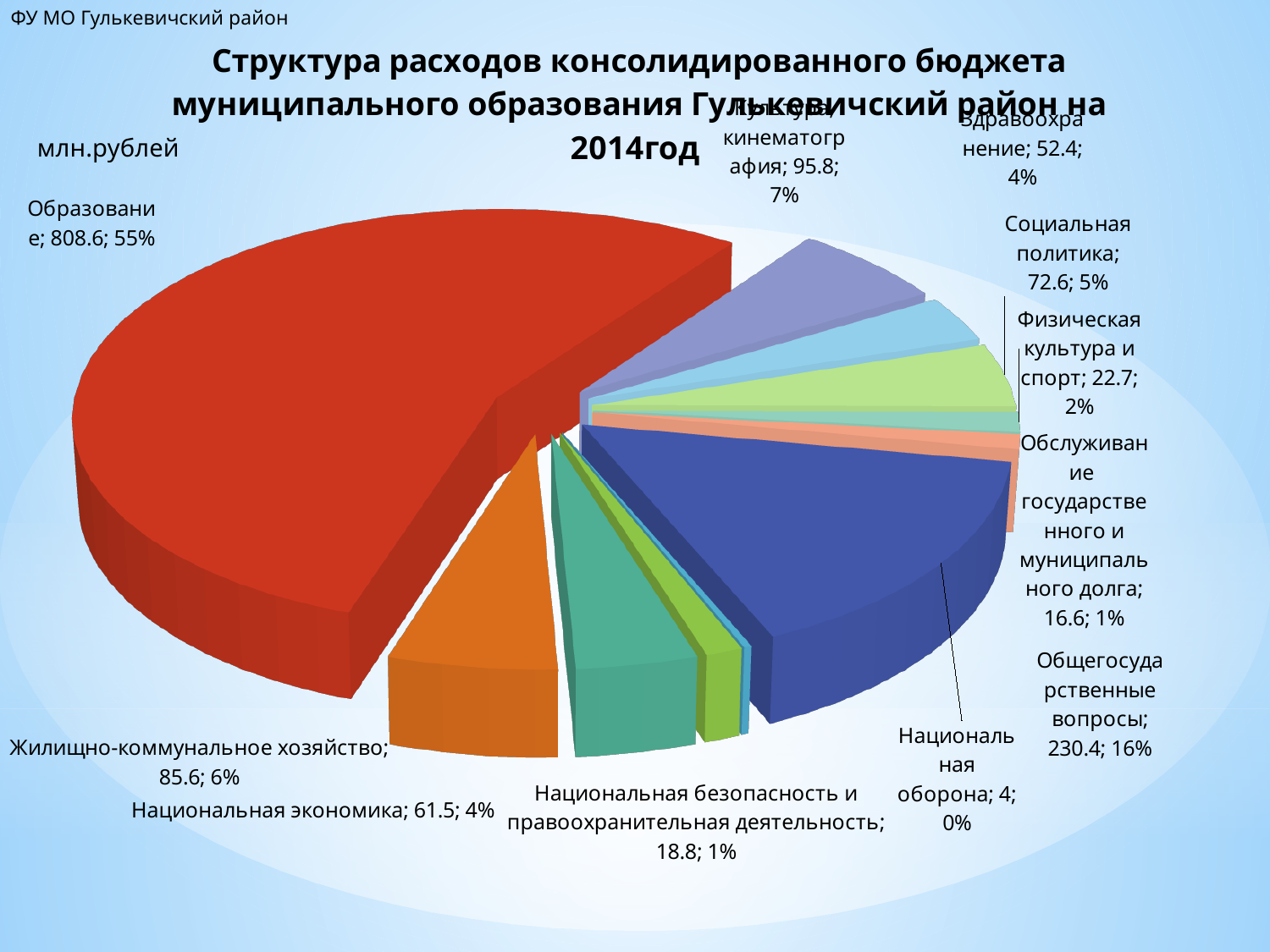
In what units are the values on the chart given, according to the slide? млн.рублей What is the value for Общегосударственные вопросы? 230.4 Which is larger, the value for Здравоохранение or the value for Социальная политика? Социальная политика What is the value for Жилищно-коммунальное хозяйство? 85.6 What kind of chart is shown on the slide? pie chart What share of the pie does Общегосударственные вопросы represent? 16% Which category has the largest slice of the pie? Образование Which category has the smallest slice of the pie? Национальная оборона How many categories (slices) does the pie chart show? 11 What share of the pie does Социальная политика represent? 5% What is the value for Образование in the pie chart? 808.6 What is the difference between the values for Жилищно-коммунальное хозяйство and Национальная экономика? 24.1